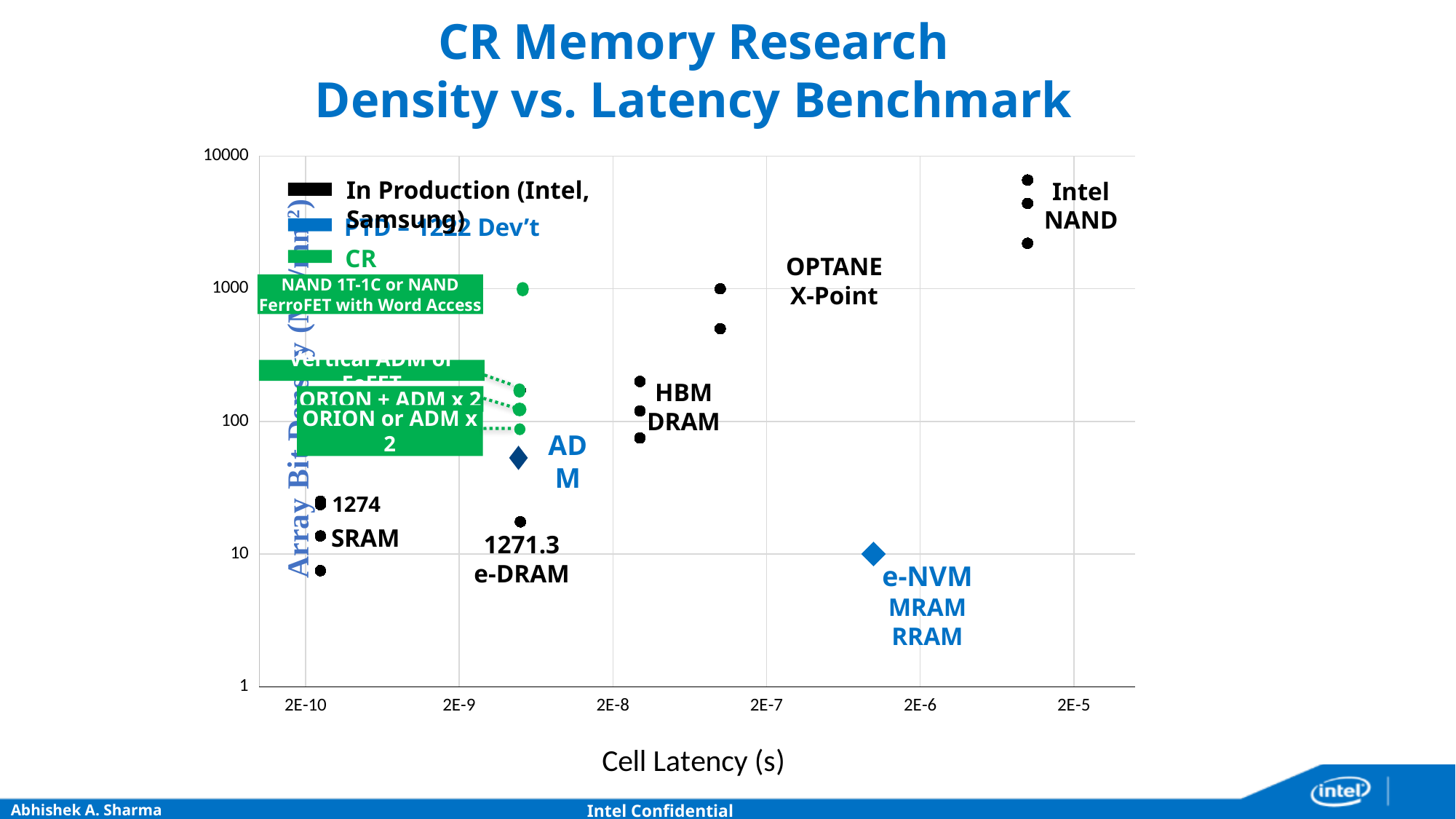
How many Intel NAND points are plotted? 3 What is the title of the x axis? Cell Latency (s) Which has the longer cell latency, OPTANE X-Point or HBM DRAM? OPTANE X-Point Is the array bit density of the e-NVM (MRAM/RRAM) point greater or less than 100? less What kind of chart is shown on the slide? Scatter chart Is the array bit density of the 1271.3 e-DRAM point greater or less than 100? less How many series does the legend list? 3 Which has the higher array bit density, Intel NAND or SRAM? Intel NAND Which labeled memory group has the highest array bit density? Intel NAND Which labeled memory group has the longest cell latency? Intel NAND Are the Intel NAND points greater or less than 1000 on the array bit density axis? greater